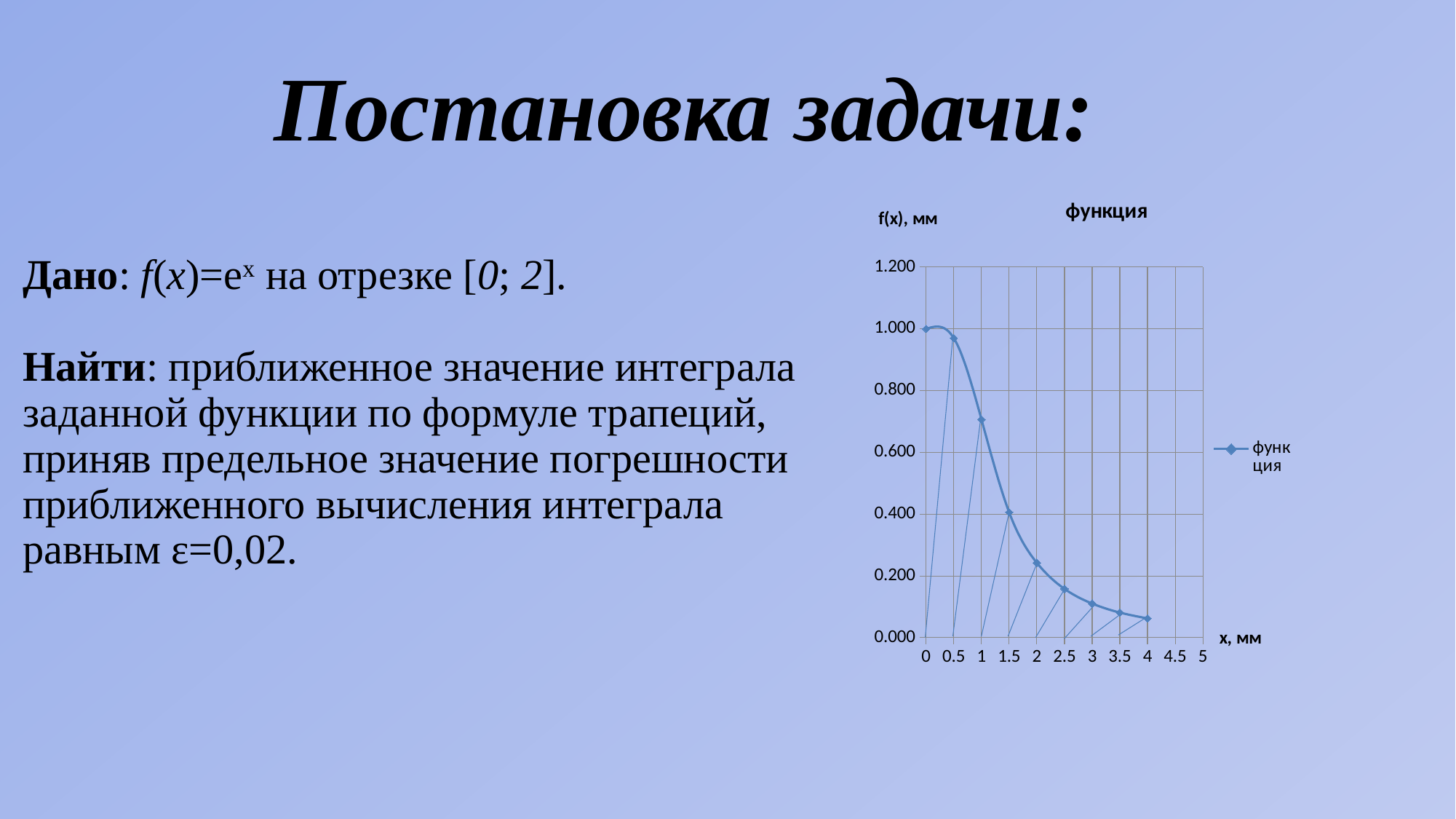
What is the title of the chart? функция How many data points are plotted on the line? 9 How many series does the chart legend list? 1 What is the label of the vertical axis? f(x), мм What kind of chart is shown on the slide? line chart Do the plotted values rise or fall as x increases? fall What is the plotted value at x = 0? 1.000 At which x value is the plotted value highest? 0 At which x value is the plotted value lowest? 4 Is the plotted value at x = 1 greater or less than 0.600? greater Is the plotted value at x = 2 greater or less than 0.400? less Which is larger, the plotted value at x = 0.5 or at x = 1.5? x = 0.5